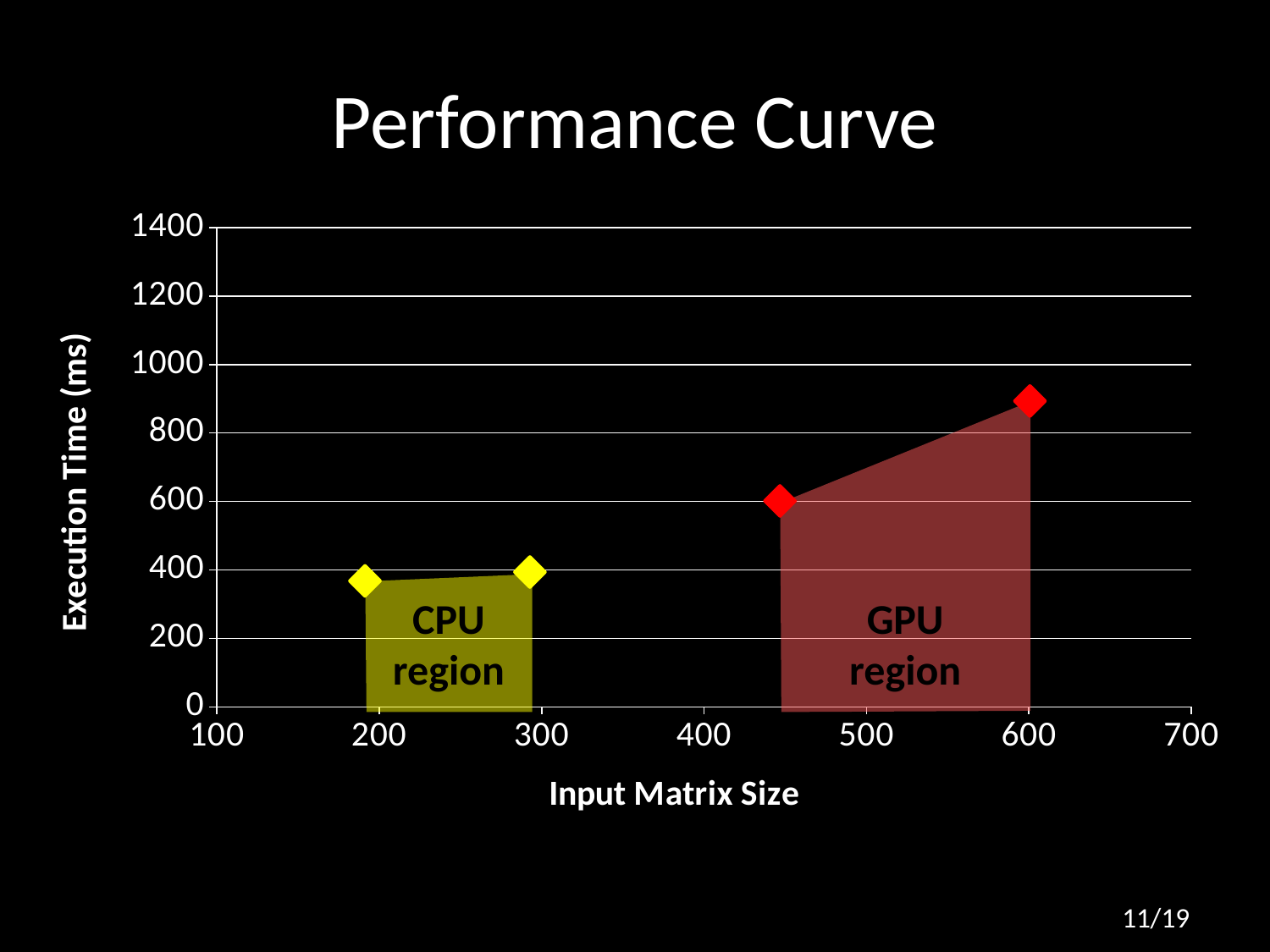
Which has the larger execution time: the point at input matrix size 450 or the point at input matrix size 300? the point at 450 Is the execution time for the point at input matrix size 600 greater or less than 800? greater Which region, CPU or GPU, contains the point with the highest execution time? GPU region Is the execution time for the point at input matrix size 200 greater or less than 600? less What is the title of the chart? Performance Curve What is the label of the y axis? Execution Time (ms) Which region, CPU or GPU, contains the point with the lowest execution time? CPU region Is the execution time for the point at input matrix size 300 greater or less than 600? less What is the highest value shown on the y axis? 1400 How many data points are plotted on the chart? 4 Do execution times rise or fall as the input matrix size increases? rise What type of chart is shown on the slide? scatter chart